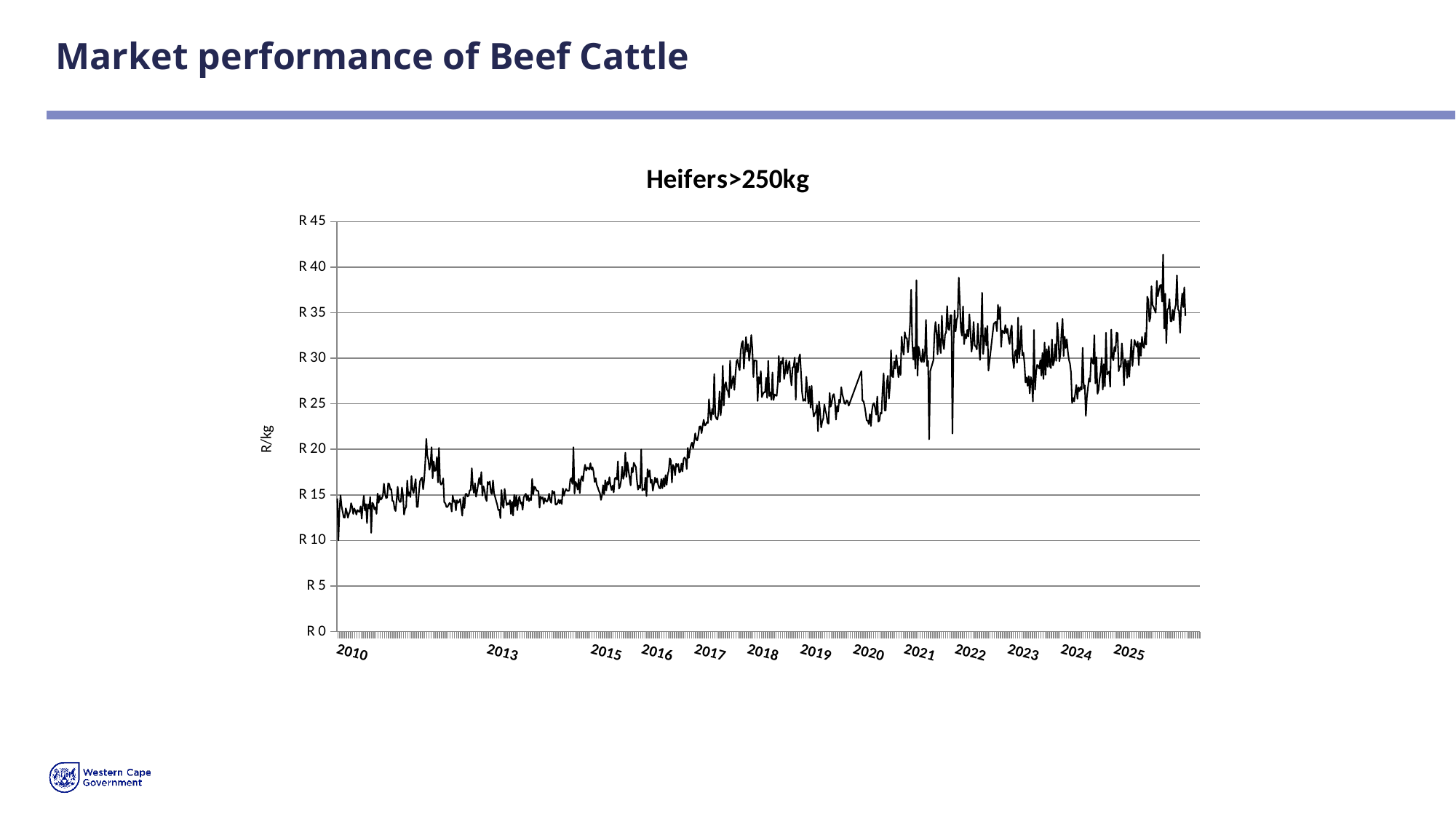
What kind of chart is shown on the slide? line chart Is the peak value reached in 2017 greater or less than R 30? greater Overall, do the values rise or fall from 2010 to 2025? rise Are the values in 2013 greater or less than R 20? less In which year does the line reach its lowest point? 2010 What is the label on the vertical axis of the chart? R/kg Is the highest value reached in 2025 greater or less than R 35? greater Are the values in 2025 higher or lower than the values in 2010? higher In which year does the line reach its highest point? 2025 What is the title of the chart? Heifers>250kg